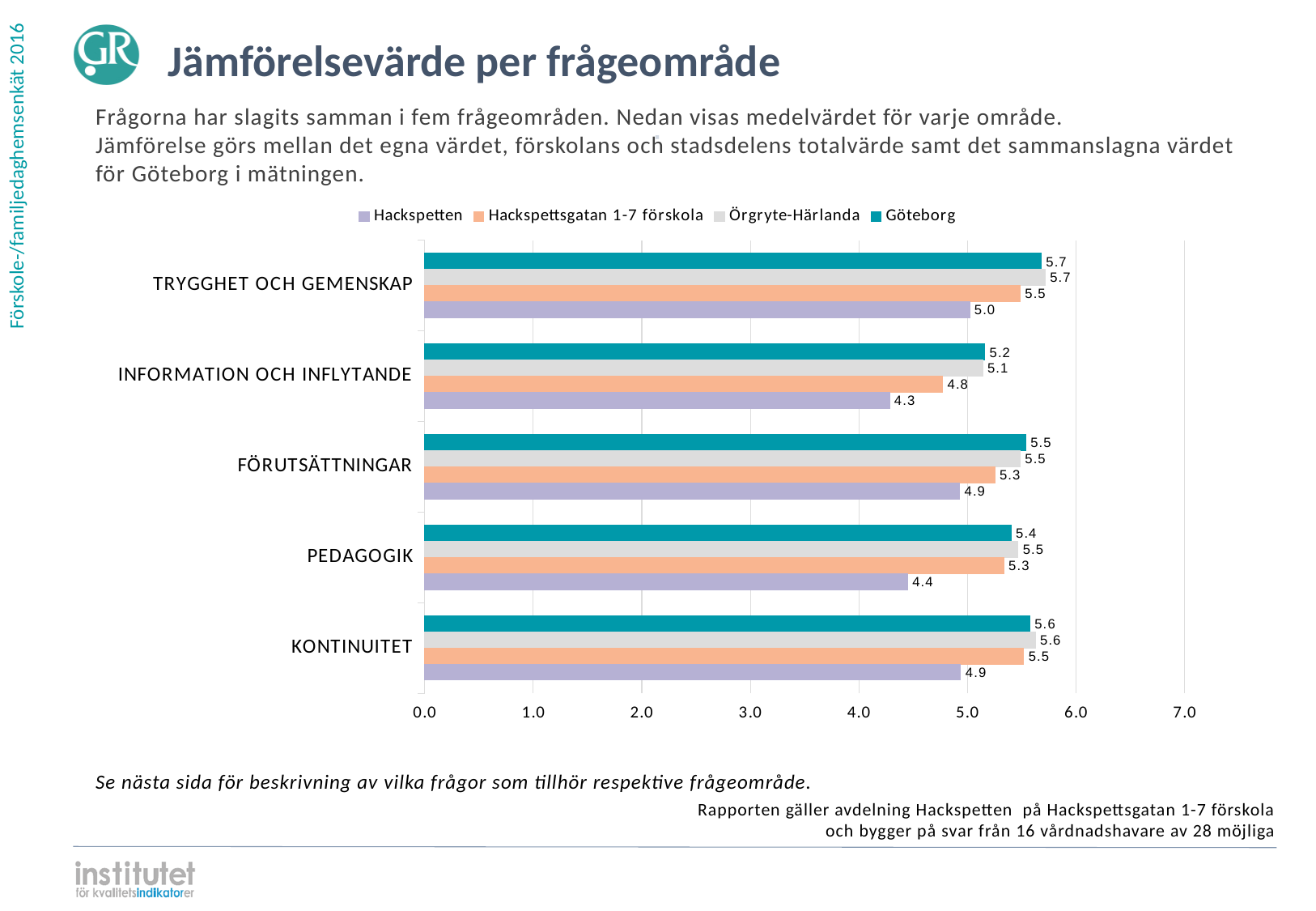
What kind of chart is shown on the slide? Bar chart In which category does Hackspetten have its lowest value? INFORMATION OCH INFLYTANDE What is the title of the slide? Jämförelsevärde per frågeområde How many series does the legend list? 4 What is the value for Örgryte-Härlanda in the TRYGGHET OCH GEMENSKAP category? 5.7 What is the value for Göteborg in the KONTINUITET category? 5.6 What is the difference between the Göteborg value and the Hackspetten value in the PEDAGOGIK category? 1.0 What is the value for Hackspetten in the INFORMATION OCH INFLYTANDE category? 4.3 In which category does Hackspetten have its highest value? TRYGGHET OCH GEMENSKAP Which is larger in the FÖRUTSÄTTNINGAR category: the value for Hackspettsgatan 1-7 förskola or the value for Hackspetten? Hackspettsgatan 1-7 förskola How many categories are shown on the chart? 5 What is the value for Hackspettsgatan 1-7 förskola in the PEDAGOGIK category? 5.3